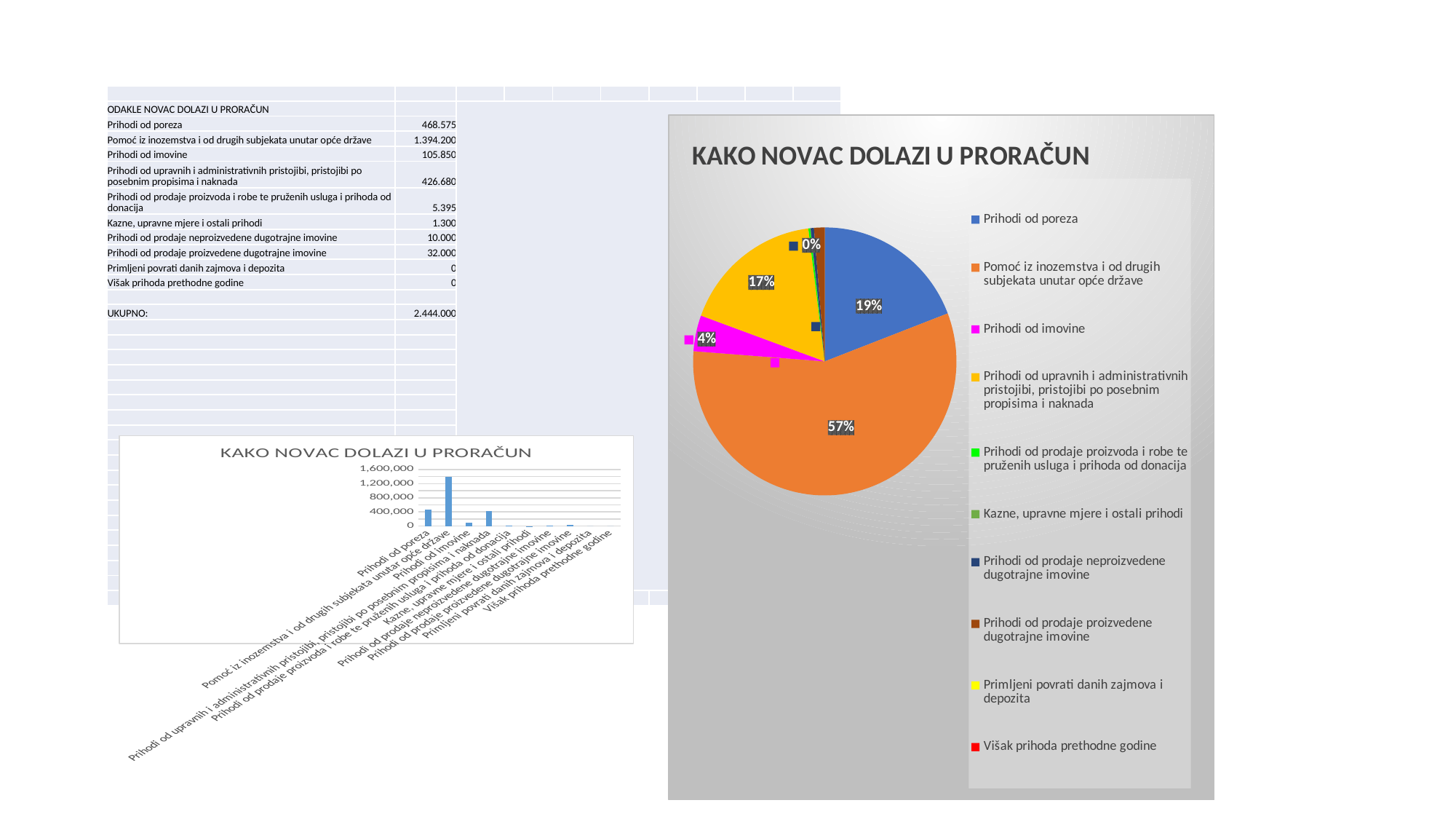
In the pie chart on the right, which category has the largest slice? Pomoć iz inozemstva i od drugih subjekata unutar opće države In the pie chart on the right, what percentage share is shown for Pomoć iz inozemstva i od drugih subjekata unutar opće države? 57% In the pie chart on the right, what percentage share is shown for Prihodi od poreza? 19% How many entries does the legend of the pie chart on the right list? 10 In the bar chart at the bottom left, is the value for Pomoć iz inozemstva i od drugih subjekata unutar opće države greater or less than 1,200,000? greater In the pie chart on the right, which share is larger: Prihodi od poreza or Prihodi od upravnih i administrativnih pristojbi, pristojbi po posebnim propisima i naknada? Prihodi od poreza In the pie chart on the right, what is the difference in percentage points between the share for Pomoć iz inozemstva i od drugih subjekata unutar opće države and the share for Prihodi od poreza? 38 percentage points In the pie chart on the right, what percentage share is shown for Prihodi od upravnih i administrativnih pristojbi, pristojbi po posebnim propisima i naknada? 17% What kind of chart is the large chart on the right of the slide? Pie chart In the bar chart at the bottom left, which category has the tallest bar? Pomoć iz inozemstva i od drugih subjekata unutar opće države What kind of chart is the small chart at the bottom left of the slide? Bar chart